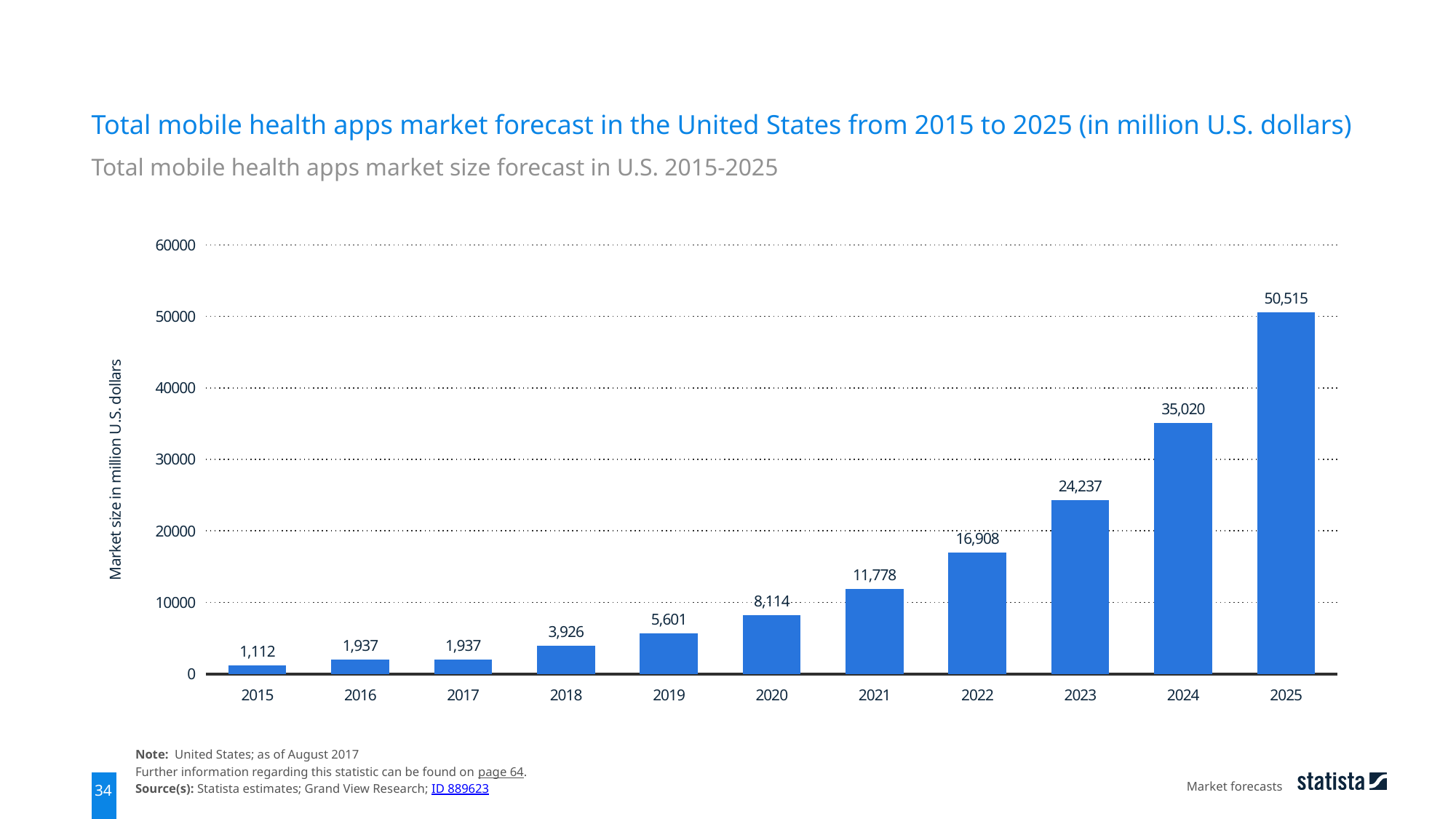
What is the market size value shown for 2015? 1,112 What is the forecast market size for 2020? 8,114 Which is larger, the value for 2021 or the value for 2022? 2022 Which year has the lowest market size? 2015 What kind of chart is shown on the slide? Bar chart Is the value for 2024 greater or less than 30000? greater Do the values generally rise or fall from 2015 to 2025? Rise How many years are shown on the x axis? 11 What is the difference between the 2025 and 2024 values? 15,495 Which year has the highest forecast market size? 2025 What is the forecast market size for 2023? 24,237 What is the difference between the 2018 and 2017 values? 1,989